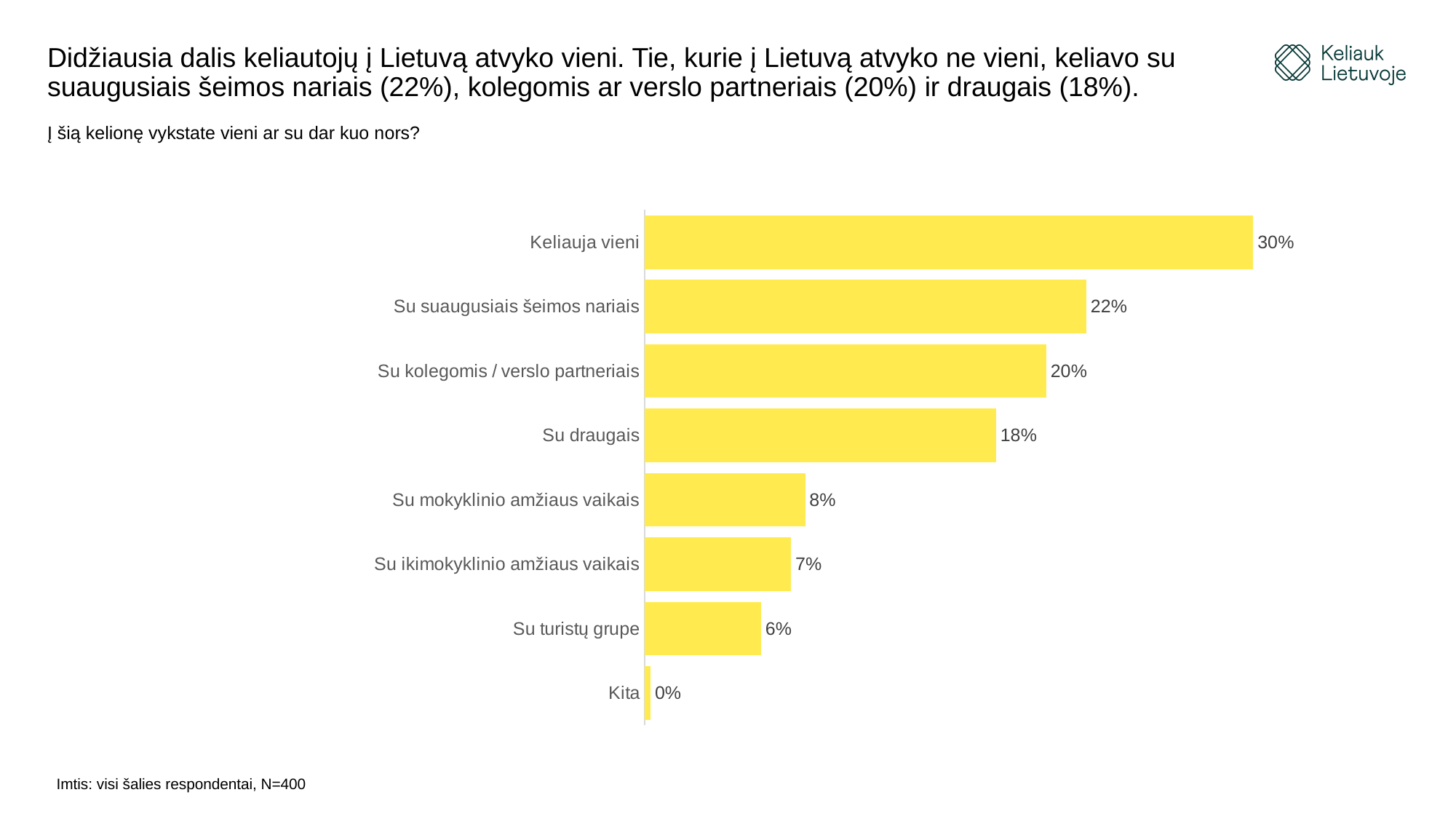
Which category has the lowest value? Kita What is the difference between "Keliauja vieni" and "Su draugais"? 12% What is the sample size stated below the chart? N=400 What is the value for "Su draugais"? 18% What colour are the bars in the chart? Yellow Which category has the highest value? Keliauja vieni Which is larger: "Su mokyklinio amžiaus vaikais" or "Su ikimokyklinio amžiaus vaikais"? Su mokyklinio amžiaus vaikais What is the value for "Su turistų grupe"? 6% What is the value for "Keliauja vieni"? 30% How many categories are shown in the chart? 8 What kind of chart is shown on the slide? Bar chart What is the difference between "Su suaugusiais šeimos nariais" and "Su kolegomis / verslo partneriais"? 2%